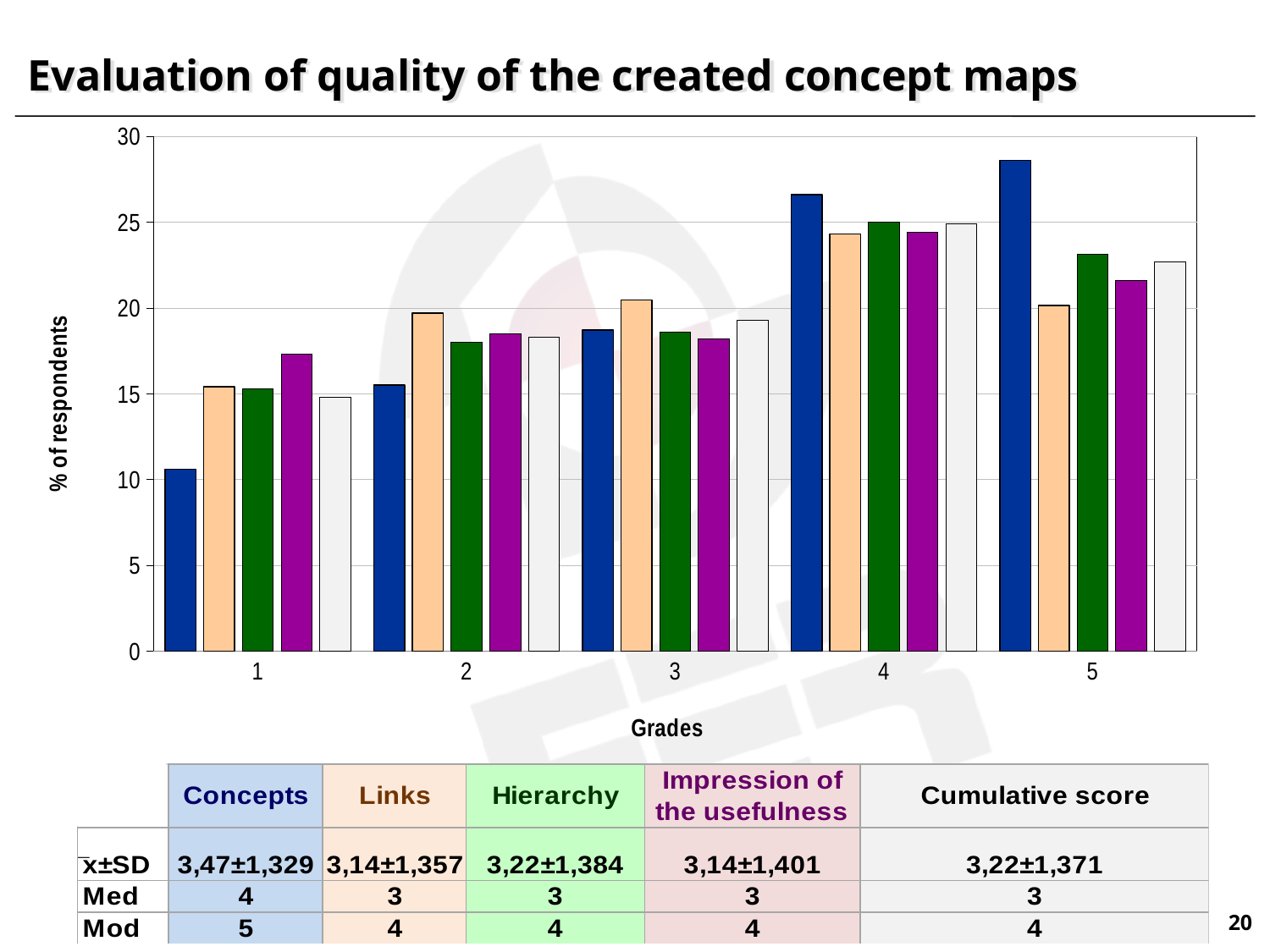
How many grade categories are shown on the x axis of the chart? 5 Is the value of the light grey bar (Cumulative score) for grade 2 greater or less than 20? less How many bars are plotted for each grade category? 5 What is the label of the y axis of the chart? % of respondents For which grade is the dark blue bar (Concepts) the lowest? 1 Is the value of the dark blue bar (Concepts) for grade 1 greater or less than 15? less For which grade is the dark blue bar (Concepts) the highest? 5 Is the value of the purple bar (Impression of the usefulness) for grade 1 greater or less than 15? greater What kind of chart is shown on the slide? bar chart Do the dark blue bars (Concepts) rise or fall as the grade increases from 1 to 5? rise What is the label of the x axis of the chart? Grades